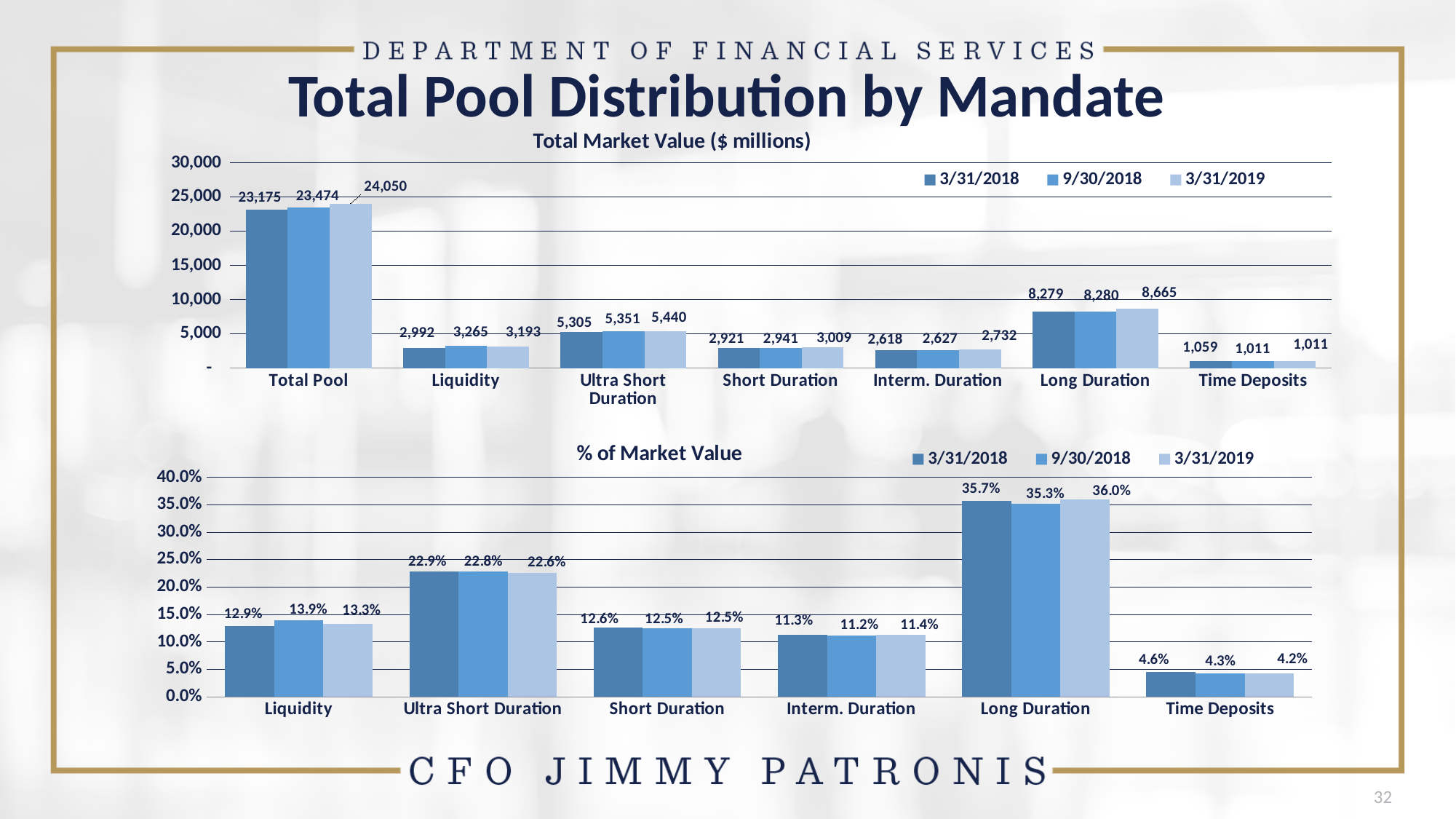
In the % of Market Value chart, which category has the highest share? Long Duration In the % of Market Value chart, is the 3/31/2018 value for Liquidity larger or smaller than the 3/31/2018 value for Ultra Short Duration? smaller In the Total Market Value ($ millions) chart, what is the value for Total Pool on 3/31/2019? 24,050 In the Total Market Value ($ millions) chart, how many series does the legend list? 3 In the Total Market Value ($ millions) chart, what is the value for Long Duration on 3/31/2018? 8,279 In the % of Market Value chart, what is the value for Time Deposits on 9/30/2018? 4.3% What kind of chart is the % of Market Value chart? bar chart In the Total Market Value ($ millions) chart, what is the difference between the Ultra Short Duration values for 3/31/2019 and 3/31/2018? 135 In the Total Market Value ($ millions) chart, how many categories are shown on the x axis? 7 In the % of Market Value chart, what is the value for Long Duration on 3/31/2019? 36.0% In the Total Market Value ($ millions) chart, which category other than Total Pool has the lowest values? Time Deposits In the % of Market Value chart, what is the difference between the Liquidity values for 9/30/2018 and 3/31/2018? 1.0%